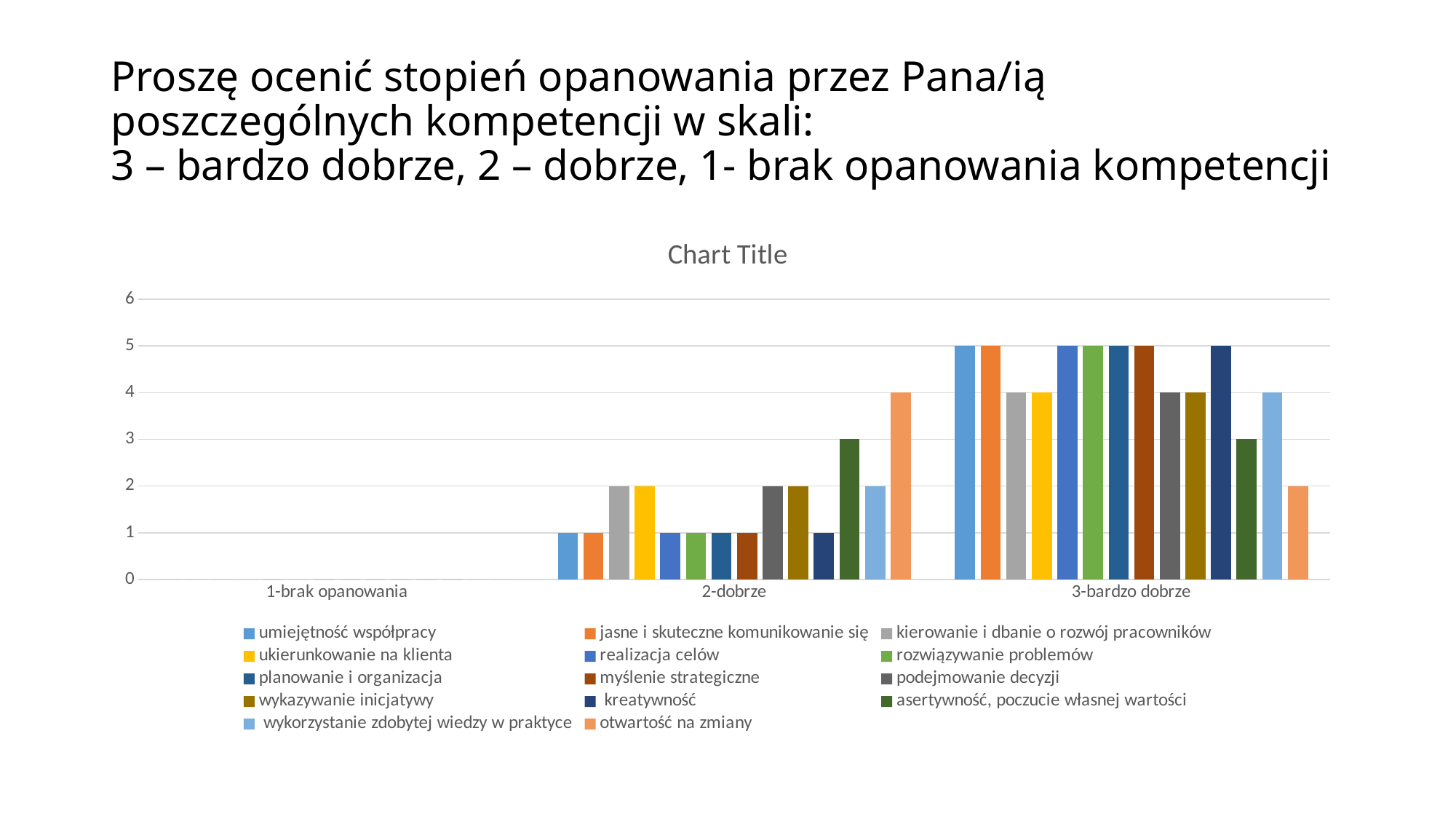
Which series has the highest value in the '2-dobrze' category? otwartość na zmiany What is the value for 'umiejętność współpracy' in the '3-bardzo dobrze' category? 5 Which series has the lowest value in the '3-bardzo dobrze' category? otwartość na zmiany What is the difference between 'otwartość na zmiany' and 'umiejętność współpracy' in the '2-dobrze' category? 3 How many series does the legend list? 14 Do the values for 'umiejętność współpracy' rise or fall from '1-brak opanowania' to '3-bardzo dobrze'? rise What kind of chart is shown on the slide? bar chart In the '3-bardzo dobrze' category, which is larger: 'realizacja celów' or 'kierowanie i dbanie o rozwój pracowników'? realizacja celów How many categories are shown on the x axis? 3 What is the value for 'asertywność, poczucie własnej wartości' in the '3-bardzo dobrze' category? 3 What is the title shown above the chart? Chart Title What is the value for 'otwartość na zmiany' in the '2-dobrze' category? 4